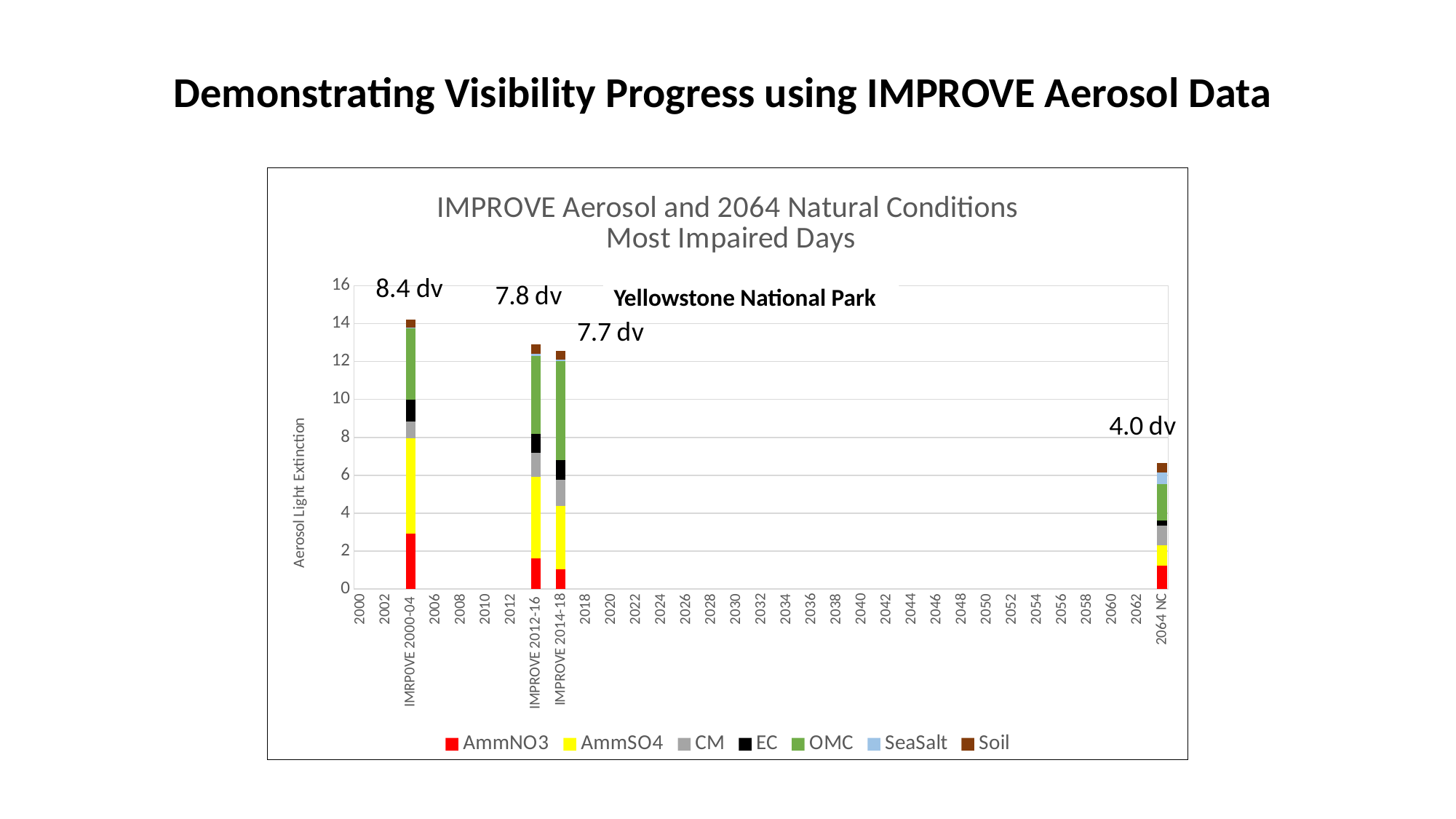
What kind of chart is shown on the slide? Stacked bar chart What deciview (dv) value is annotated above the 2064 NC bar? 4.0 dv Do the bar totals rise or fall from IMRPOVE 2000-04 to 2064 NC along the x axis? fall Is the total for the IMPROVE 2012-16 bar greater or less than 12? greater Which bar has the highest total aerosol light extinction? IMRPOVE 2000-04 How many bars are plotted in the chart? 4 How many series does the legend list? 7 Is the total for the 2064 NC bar greater or less than 8? less Which bar is taller, IMRPOVE 2000-04 or 2064 NC? IMRPOVE 2000-04 Is the AmmNO3 value for IMRPOVE 2000-04 greater or less than 2? greater What deciview (dv) value is annotated above the IMRPOVE 2000-04 bar? 8.4 dv Which bar has the lowest total aerosol light extinction? 2064 NC